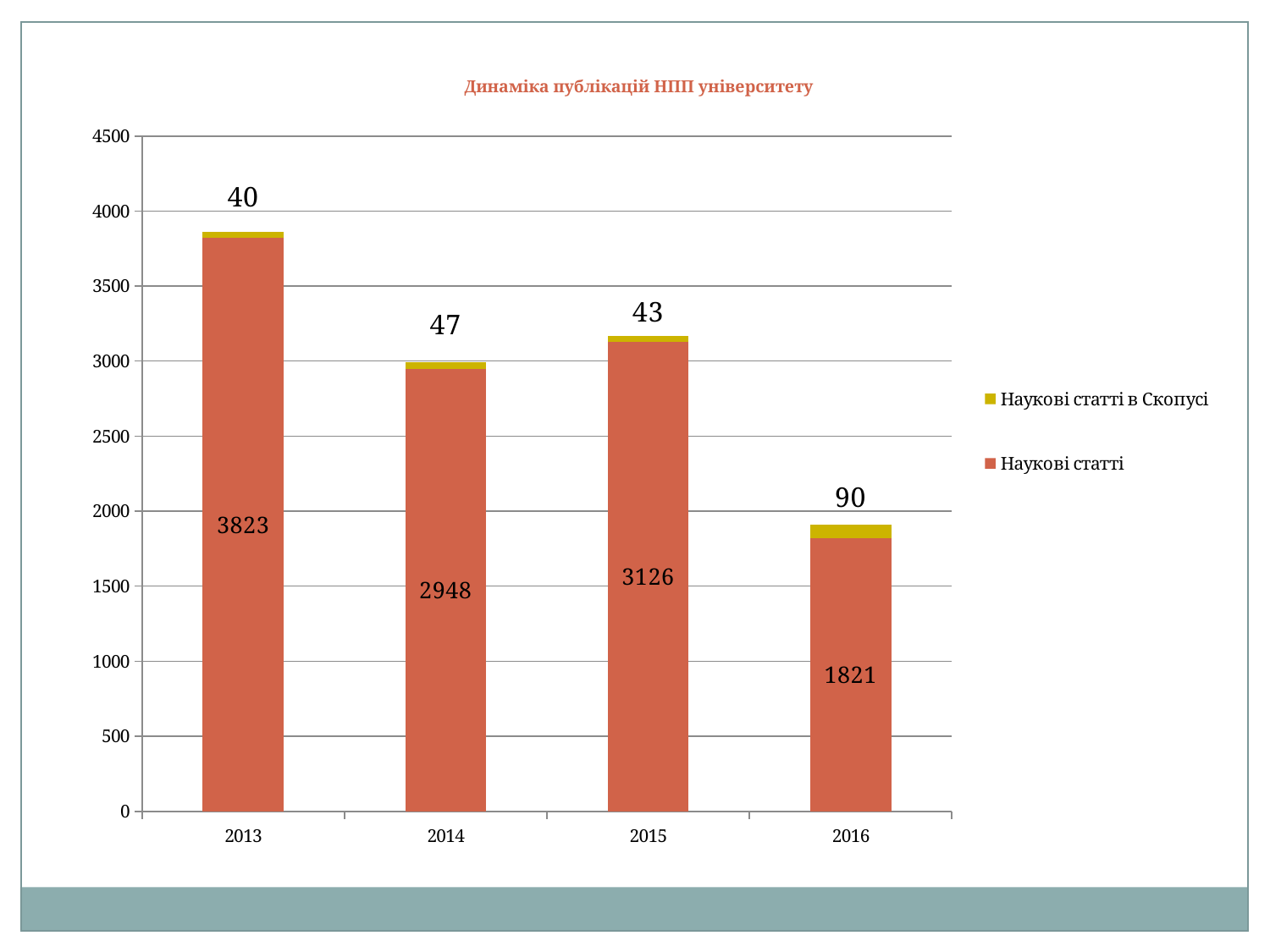
Which is larger, the "Наукові статті" value for 2014 or for 2015? 2015 How many series does the legend list? 2 Which year has the lowest value for "Наукові статті в Скопусі"? 2013 What kind of chart is shown on the slide? Stacked bar chart How many years are shown on the x axis? 4 Which year has the highest value for "Наукові статті"? 2013 What is the value of "Наукові статті" for 2013? 3823 What is the difference between the "Наукові статті" values for 2013 and 2016? 2002 What is the value of "Наукові статті в Скопусі" for 2016? 90 What is the total of the stacked bar for 2014? 2995 What is the value of "Наукові статті" for 2015? 3126 What is the title of the chart? Динаміка публікацій НПП університету